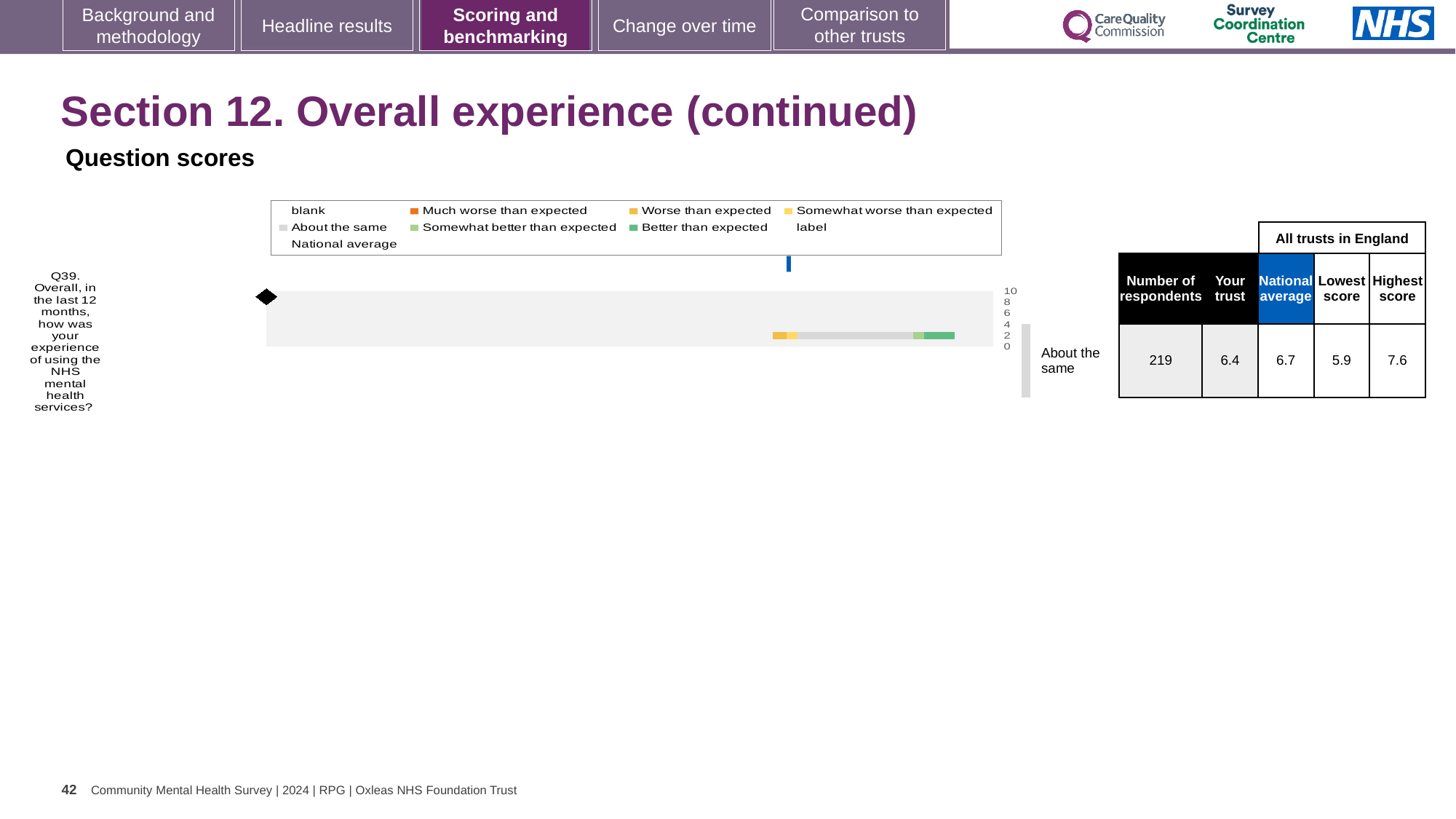
What kind of chart is used to show the Q39 score? Bar chart How many survey questions are plotted on the chart? 1 Is the 'Your trust' score for Q39 greater or less than 6? greater What is the difference between the highest score and the lowest score for Q39? 1.7 What is the highest score among all trusts in England for Q39? 7.6 What is the national average score for Q39 shown on the slide? 6.7 Which is larger for Q39: the 'Your trust' score or the national average? National average How many respondents answered Q39? 219 What is the lowest score among all trusts in England for Q39? 5.9 By how much does the national average exceed the 'Your trust' score for Q39? 0.3 Which benchmark category is the trust's Q39 score placed in? About the same What is the 'Your trust' score for Q39 (Overall, in the last 12 months, how was your experience of using the NHS mental health services?)? 6.4